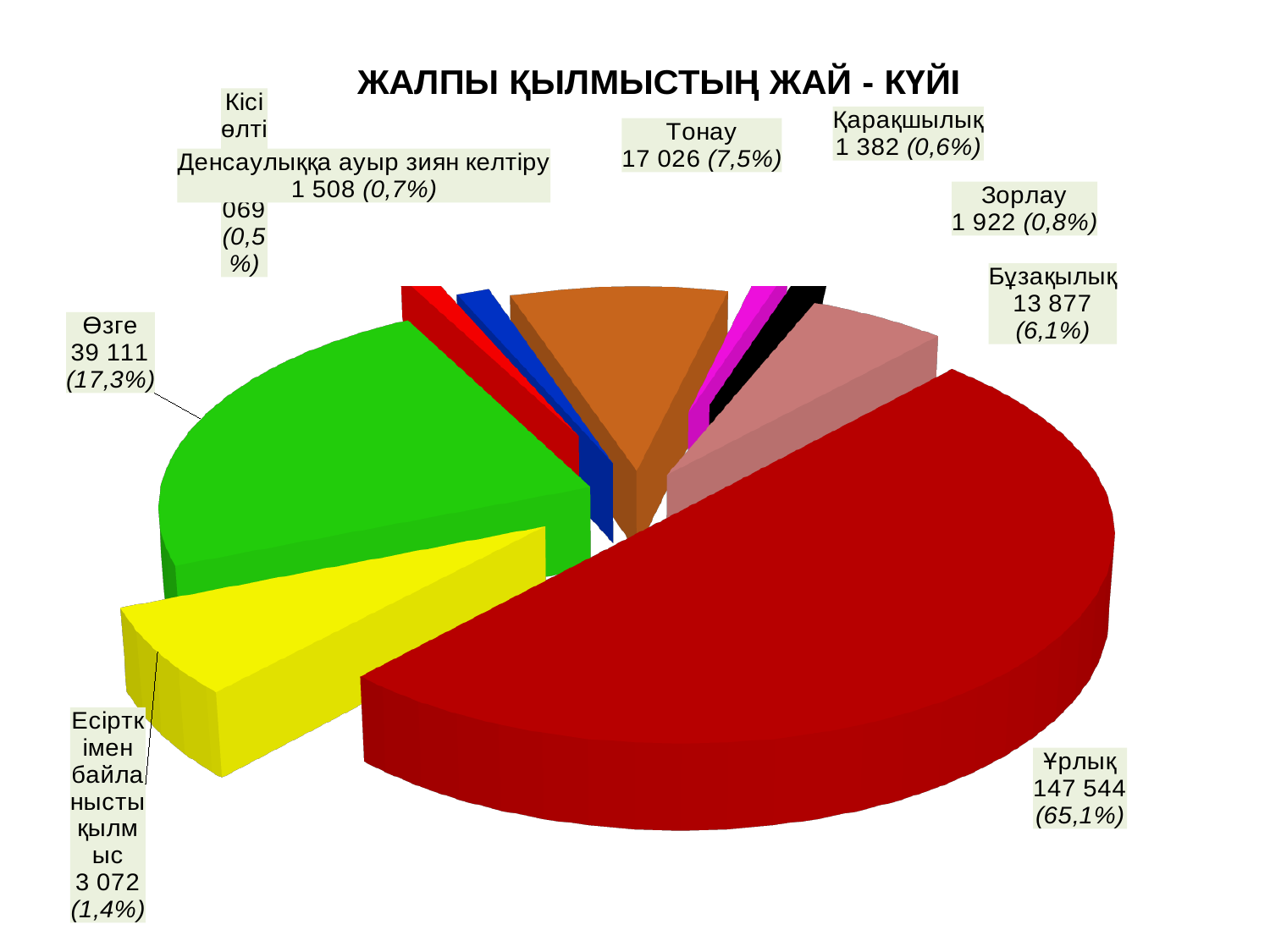
Which is larger, Тонау or Бұзақылық? Тонау What share of the pie does Ұрлық represent? 65,1% Which category has the largest slice? Ұрлық What type of chart is shown on the slide? pie chart What is the title of the chart? ЖАЛПЫ ҚЫЛМЫСТЫҢ ЖАЙ - КҮЙІ What is the value for Зорлау? 1 922 What share of the pie does Өзге represent? 17,3% What is the value for Ұрлық? 147 544 What is the value for Өзге? 39 111 What is the difference between the values for Ұрлық and Өзге? 108 433 What is the value for Бұзақылық? 13 877 What is the value for Тонау? 17 026